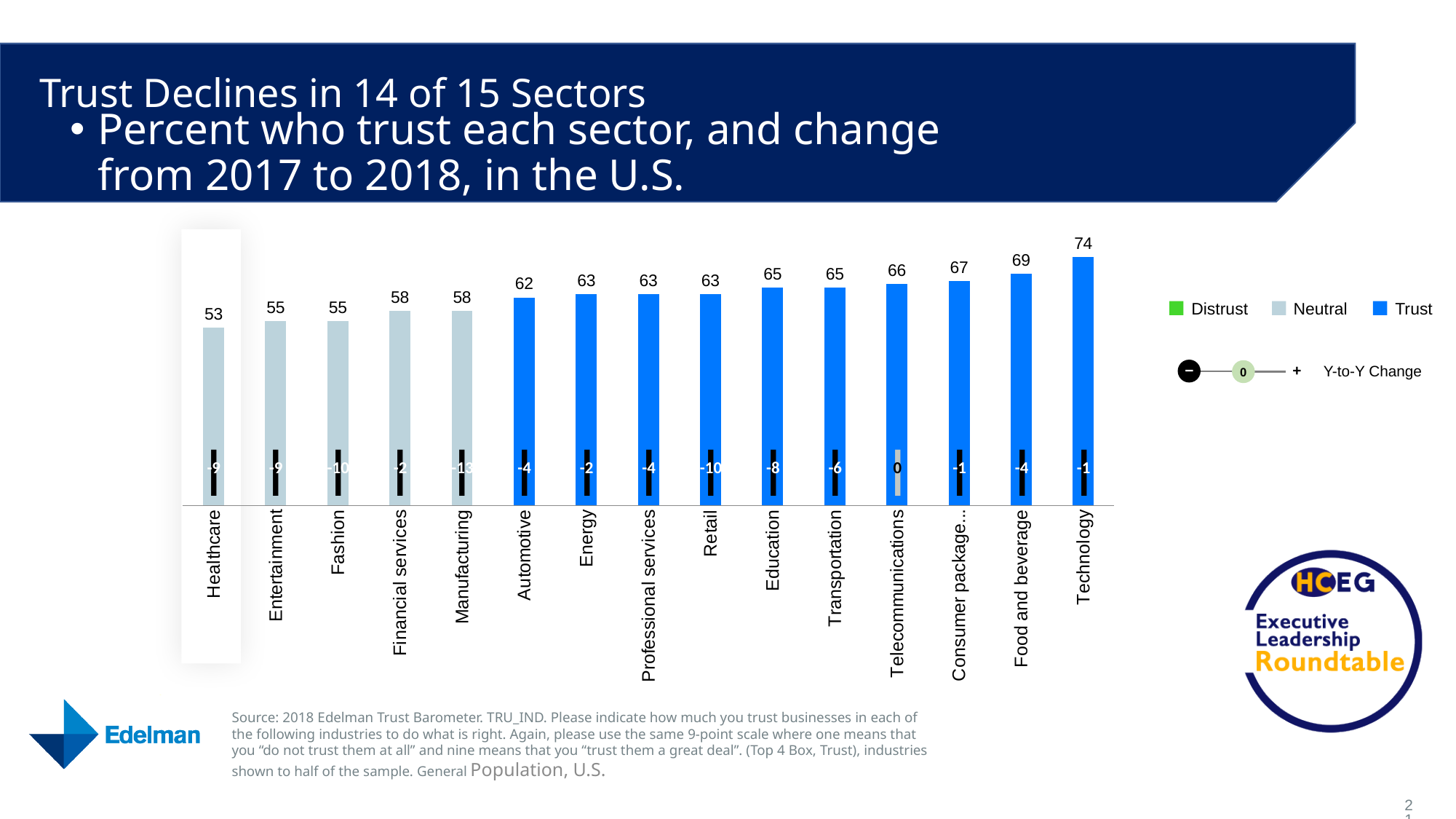
Do the trust values rise or fall moving from left to right across the sectors? Rise How many entries does the colour legend list? 3 What kind of chart is shown on the slide? Bar chart Which sector has the lowest percent who trust it? Healthcare What is the percent who trust the Technology sector? 74 How many sectors are shown on the chart? 15 What is the difference between the trust values for Technology and Healthcare? 21 What is the year-to-year change shown for the Manufacturing sector? -13 What is the percent who trust the Healthcare sector? 53 Which sector has the highest percent who trust it? Technology What is the percent who trust the Education sector? 65 Which has a higher trust value, Automotive or Food and beverage? Food and beverage